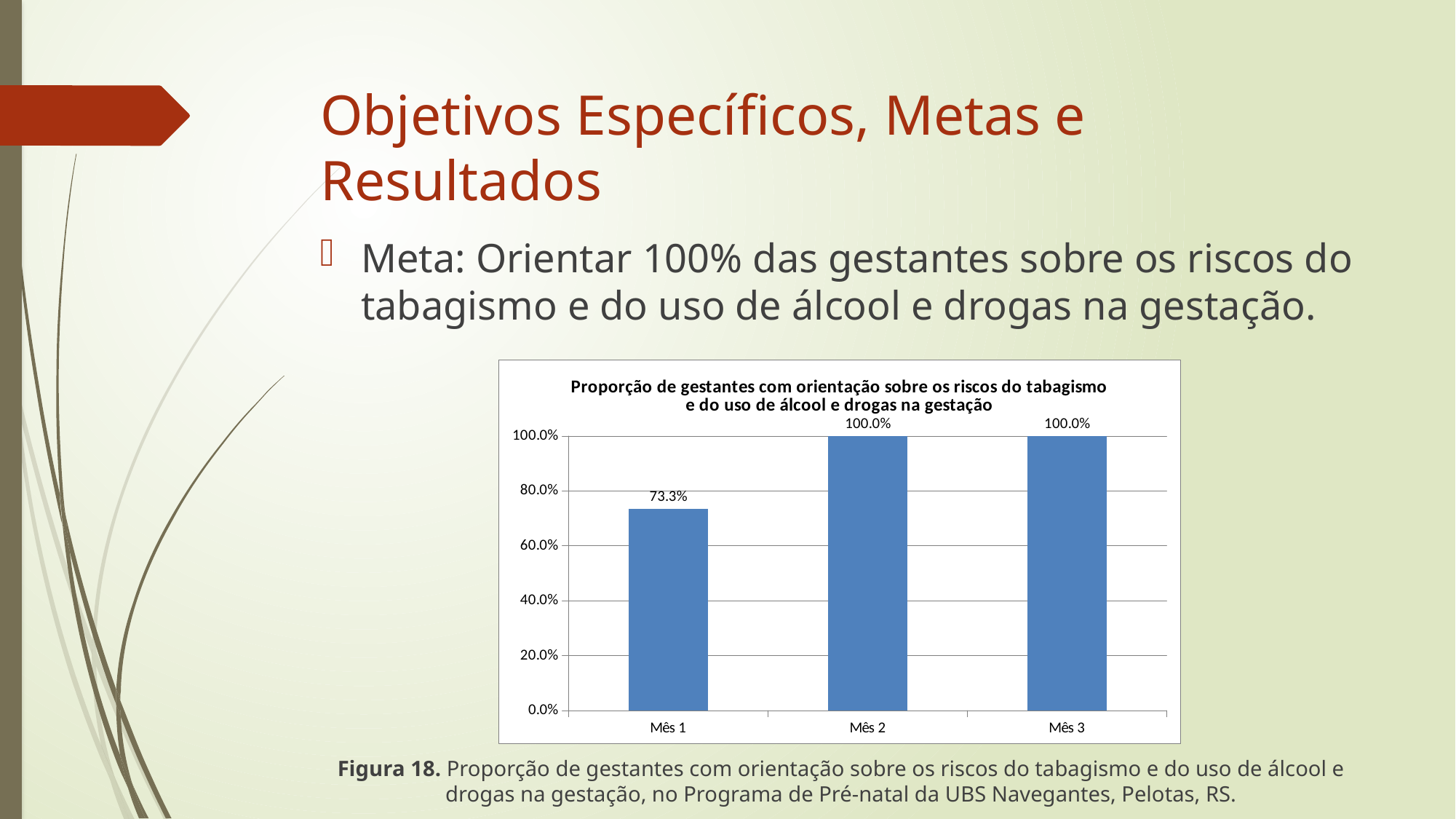
What is the value for Mês 3? 100.0% Which is larger, the value for Mês 1 or the value for Mês 3? Mês 3 What colour are the bars? blue Do the values rise or fall from Mês 1 to Mês 2? rise How many months are shown on the x axis? 3 What is the title of the chart? Proporção de gestantes com orientação sobre os riscos do tabagismo e do uso de álcool e drogas na gestação What is the difference between the values for Mês 2 and Mês 1? 26.7% What kind of chart is shown? bar chart What is the value for Mês 1? 73.3% Which month has the lowest value? Mês 1 What is the value for Mês 2? 100.0% Is the value for Mês 1 greater or less than 80.0%? less